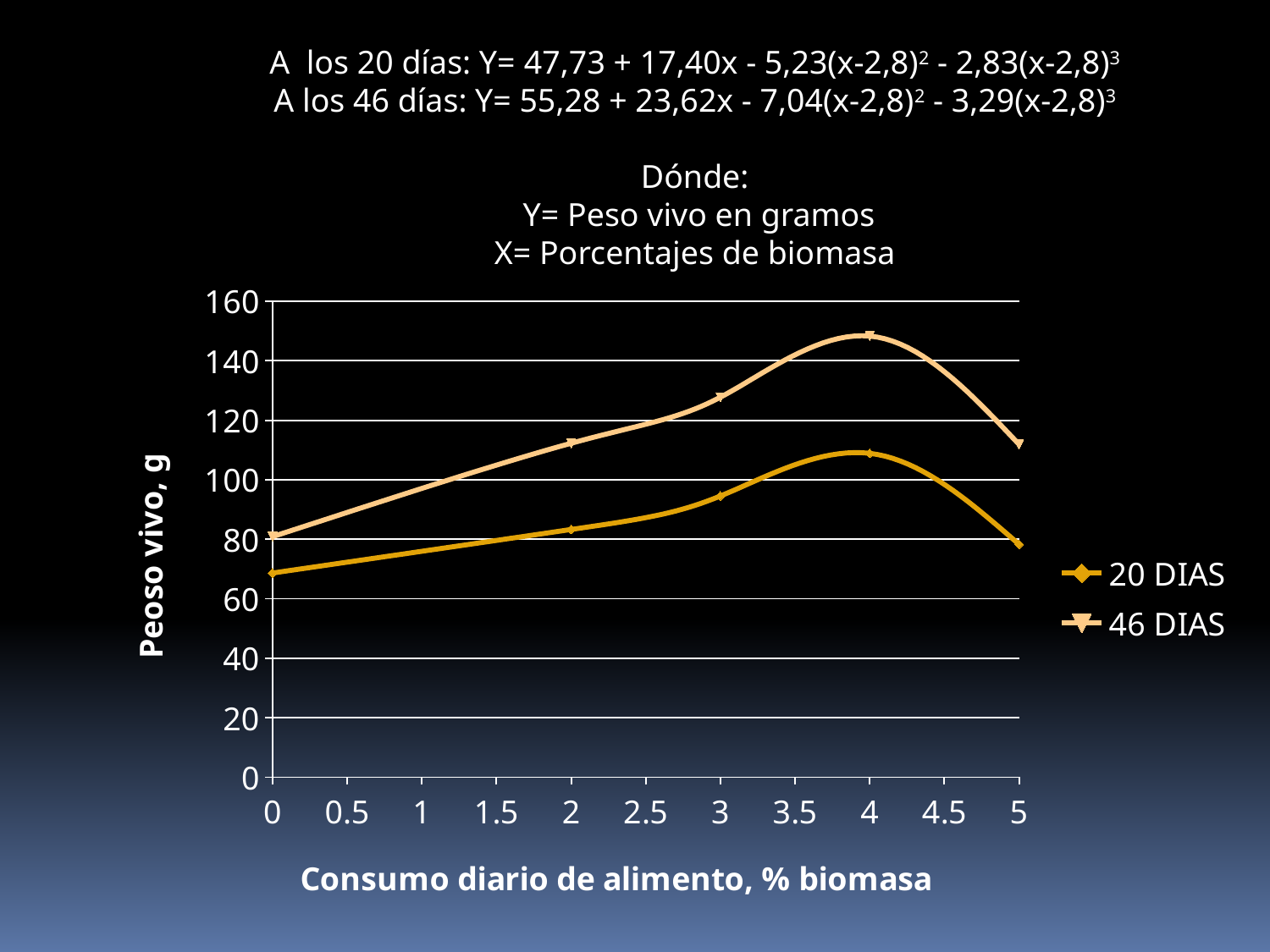
At which x value does the 20 DIAS series reach its lowest point? 0 Is the value for 46 DIAS at x = 3 greater or less than 120? greater What is the title of the x axis? Consumo diario de alimento, % biomasa Is the value for 20 DIAS at x = 4 greater or less than 100? greater Is the value for 20 DIAS at x = 0 greater or less than 80? less Does the 20 DIAS series rise or fall between x = 4 and x = 5? fall What are the two series named in the legend? 20 DIAS and 46 DIAS How many series does the legend list? 2 What kind of chart is shown on the slide? line chart Which series has the higher value at x = 3, 20 DIAS or 46 DIAS? 46 DIAS At which x value does the 46 DIAS series reach its highest point? 4